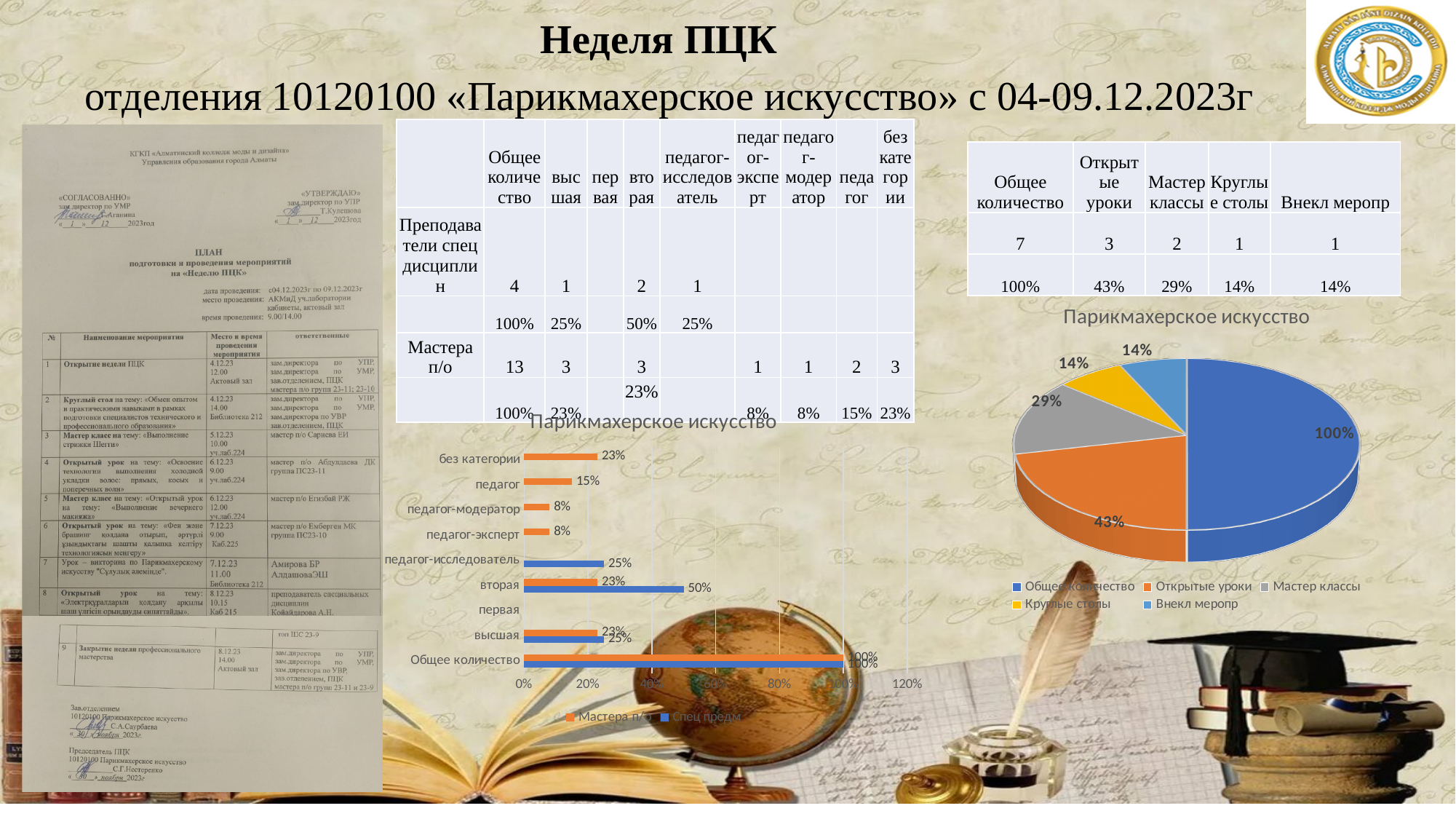
How many series does the legend of the bar chart list? 2 In the bar chart, which is larger for 'высшая': the 'Мастера п/о' value or the 'Спец предм' value? Спец предм In the bar chart, what is the value for 'педагог-исследователь' in the 'Спец предм' series? 25% In the bar chart, what is the difference between the 'Спец предм' and 'Мастера п/о' values for 'вторая'? 27% In the bar chart, what is the value for 'без категории' in the 'Мастера п/о' series? 23% What kind of chart is the chart at the bottom centre of the slide? bar chart In the bar chart, what is the value for 'педагог' in the 'Мастера п/о' series? 15% How many entries does the legend of the pie chart list? 5 How many categories are shown on the vertical axis of the bar chart? 9 What kind of chart is the chart on the right side of the slide? pie chart In the bar chart, what is the value for 'вторая' in the 'Спец предм' series? 50% In the pie chart, what is the share labelled for the 'Открытые уроки' slice? 43%